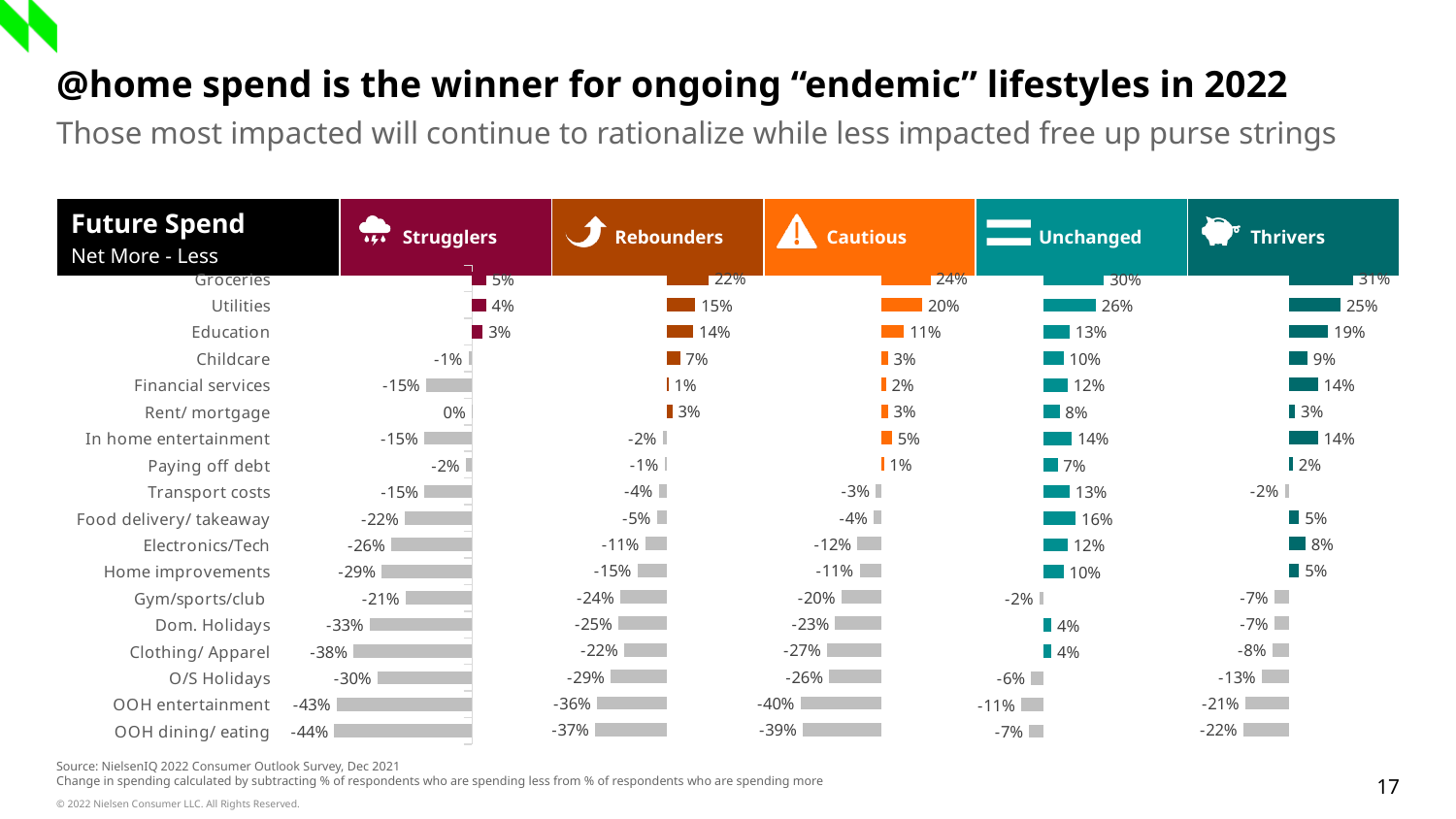
What type of chart is used to show the Future Spend data? Bar chart In the Strugglers chart, what is the value for Rent/ mortgage? 0% Which is larger: the Home improvements value in the Rebounders chart or in the Cautious chart? Cautious In the Unchanged chart, what is the value for Food delivery/ takeaway? 16% In the Thrivers chart, which category has the highest value? Groceries In the Thrivers chart, what is the value for Education? 19% What is the difference between the Utilities value in the Thrivers chart and the Utilities value in the Strugglers chart? 21 percentage points In the Rebounders chart, which category has the lowest value? OOH dining/ eating In the Unchanged chart, which category has the lowest value? OOH entertainment In the Cautious chart, what is the value for Clothing/ Apparel? -27% How many spending categories are listed in each chart? 18 In the Strugglers chart, what is the value for OOH dining/ eating? -44%